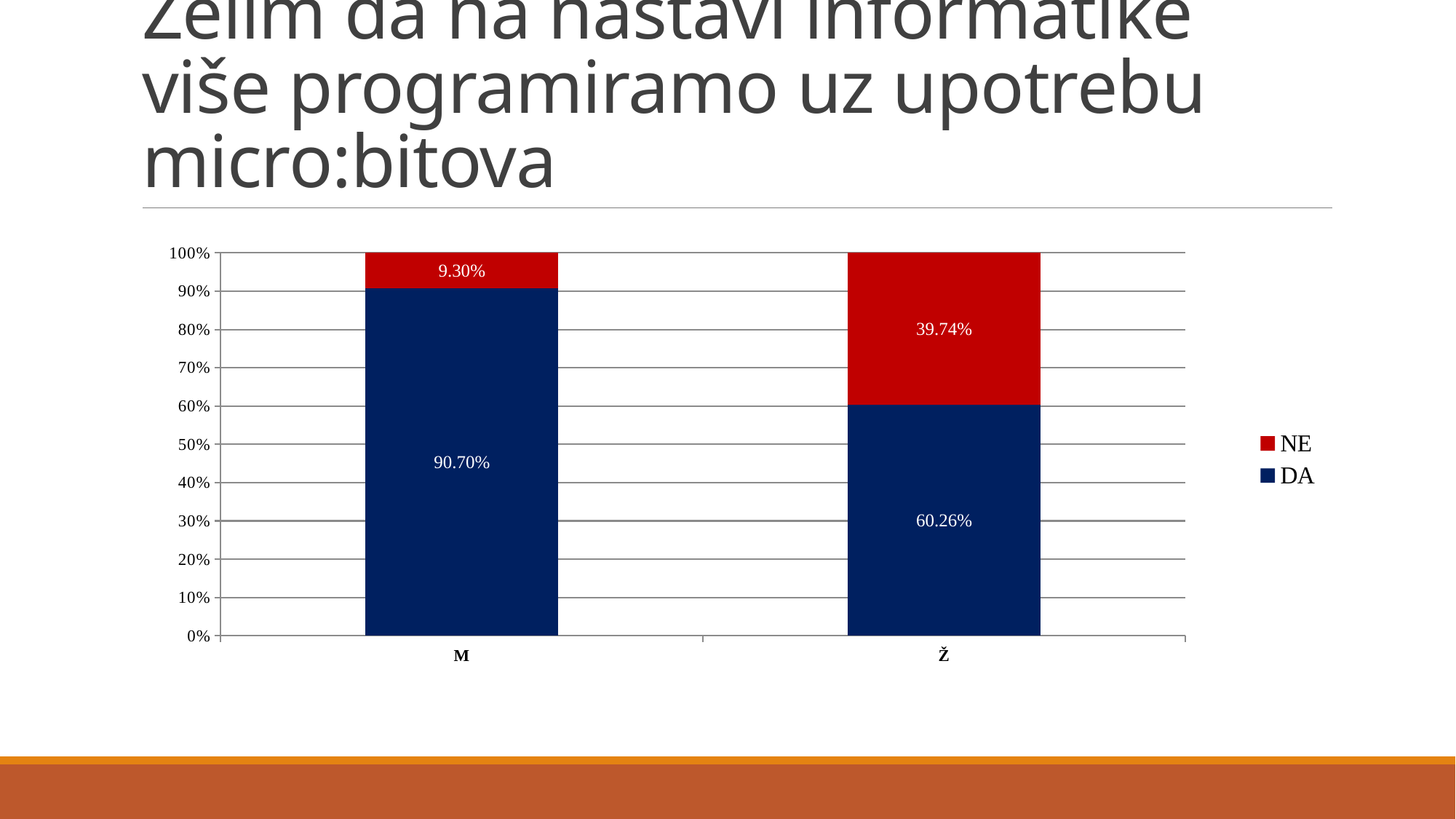
What kind of chart is shown on the slide? stacked bar chart What is the NE value for Ž? 39.74% What is the difference between the NE values for Ž and M? 30.44% Which category has the highest NE value? Ž What is the DA value for M? 90.70% What is the DA value for Ž? 60.26% How many categories are shown on the x axis? 2 Is the DA value for Ž greater or less than 50%? greater How many series does the legend list? 2 What is the difference between the DA values for M and Ž? 30.44% Which category has the higher DA value, M or Ž? M What is the NE value for M? 9.30%